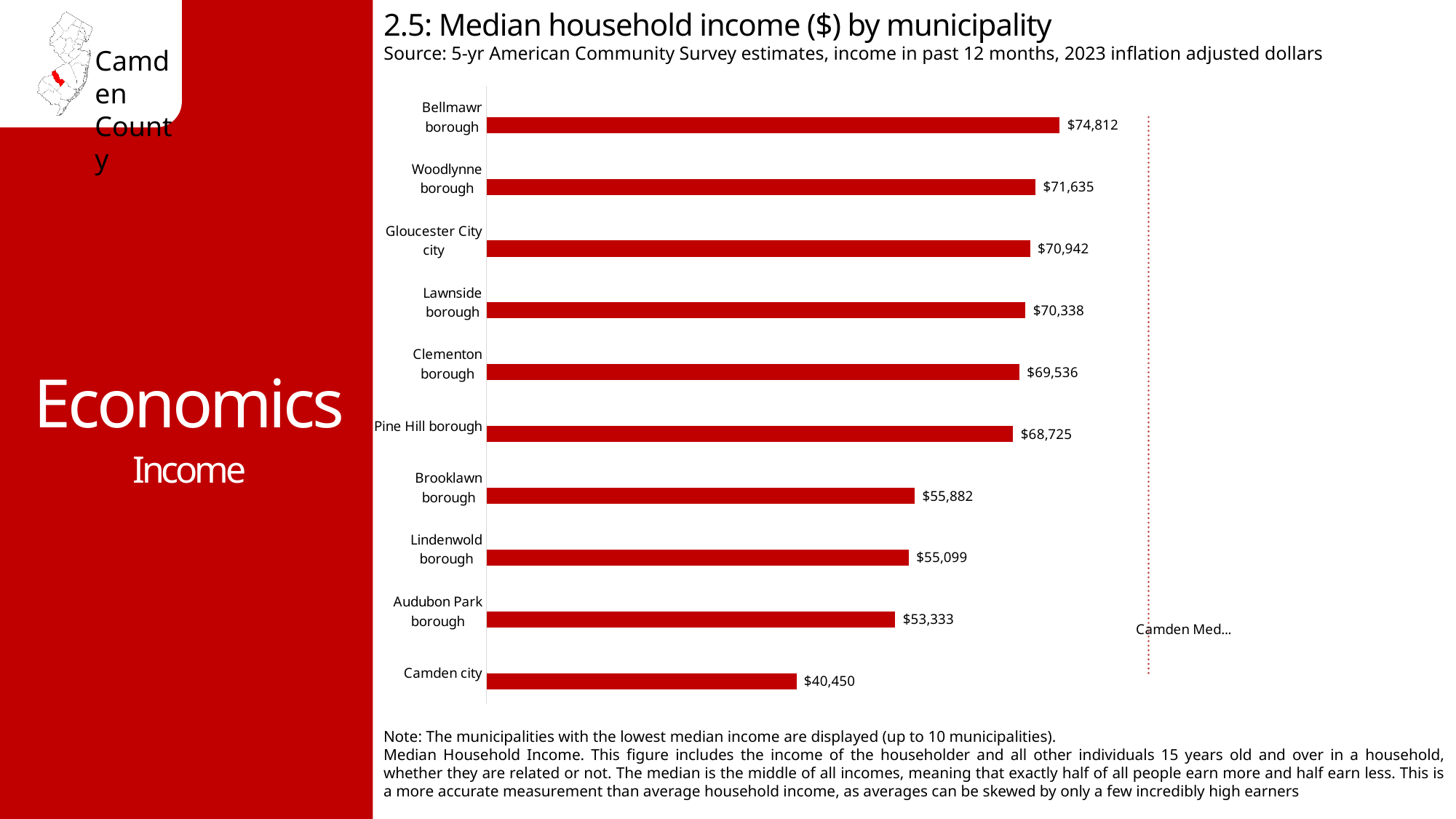
What is the median household income for Pine Hill borough? $68,725 What is the median household income for Lindenwold borough? $55,099 What is the title of the chart? 2.5: Median household income ($) by municipality How many municipalities are shown on the chart? 10 What is the difference in median household income between Brooklawn borough and Audubon Park borough? $2,549 Which municipality has the highest median household income shown on the chart? Bellmawr borough What is the difference in median household income between Bellmawr borough and Camden city? $34,362 What type of chart is used on this slide? Bar chart What is the median household income for Camden city? $40,450 What is the median household income for Bellmawr borough? $74,812 Which has a higher median household income, Woodlynne borough or Clementon borough? Woodlynne borough Which municipality has the lowest median household income shown on the chart? Camden city